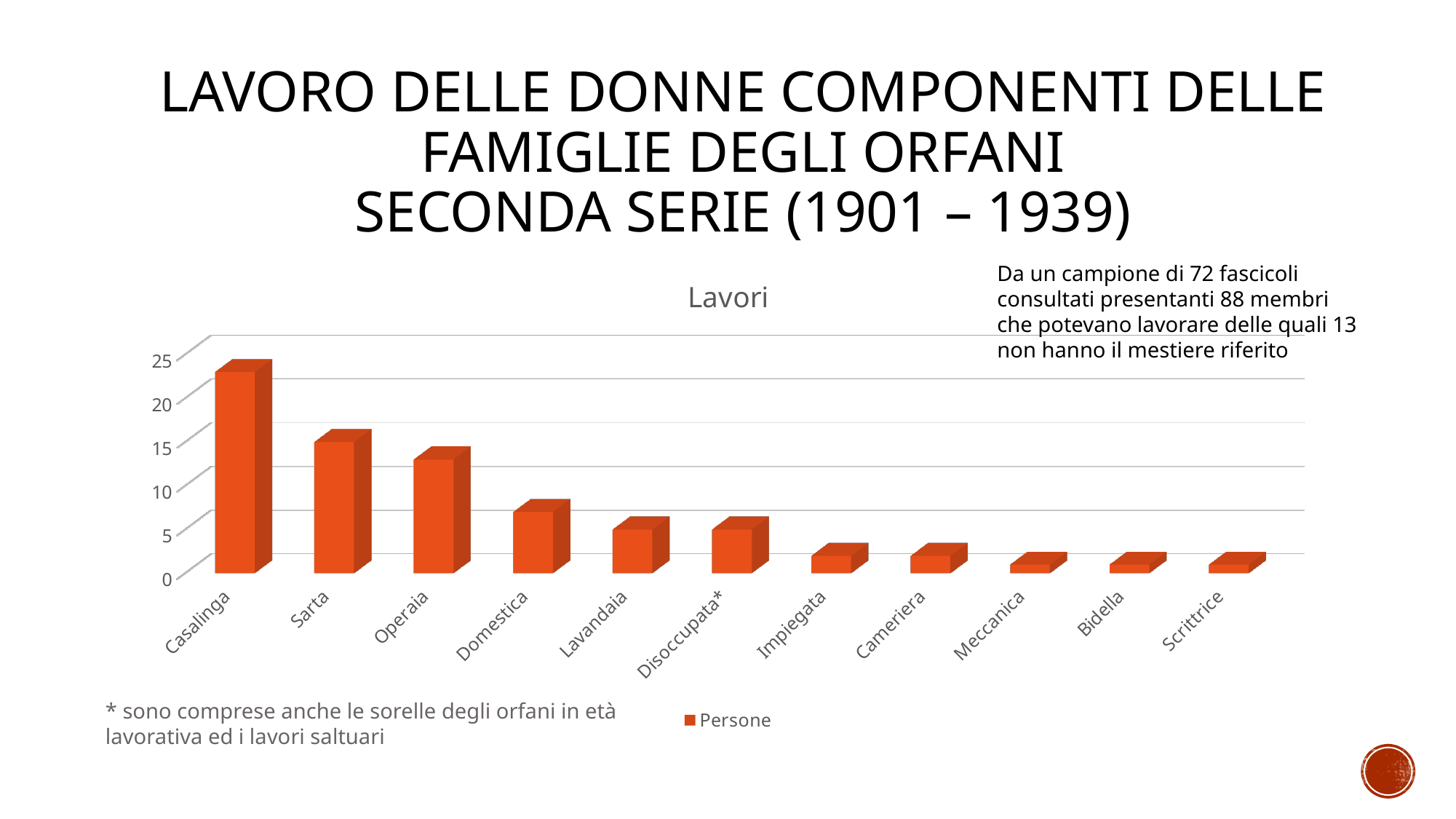
What is the name of the series in the chart legend? Persone What is the title of the chart? Lavori Is the value for Sarta greater or less than 10? greater Do the values rise or fall moving from left to right along the x axis? fall What kind of chart is shown on the slide? bar chart Which category has the highest value in the chart? Casalinga How many series does the chart legend list? 1 Is the value for Casalinga greater or less than 20? greater Is the value for Impiegata greater or less than 5? less Which is larger, the value for Sarta or the value for Domestica? Sarta How many categories are shown on the x axis of the chart? 11